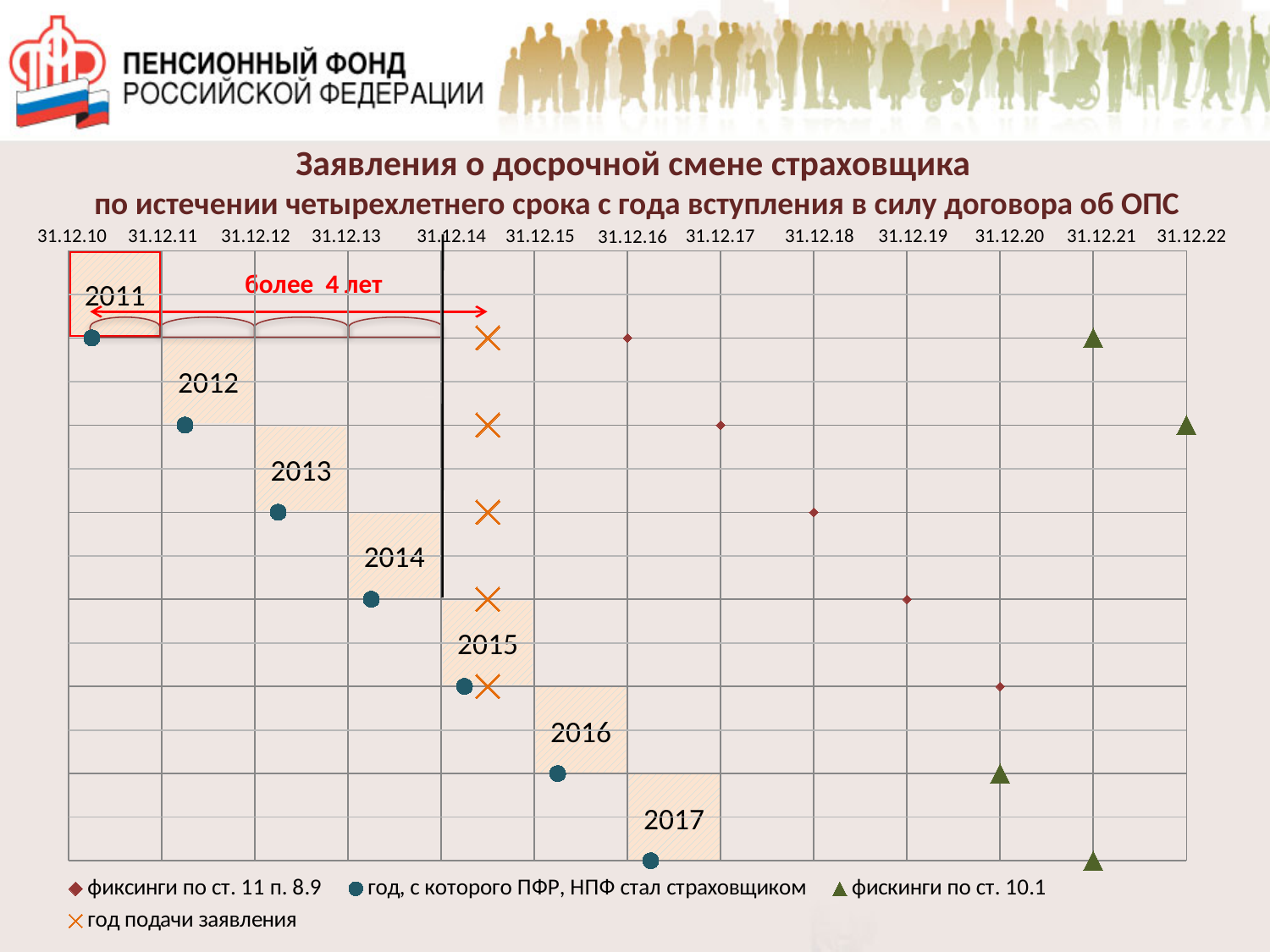
What kind of chart is shown on the slide? scatter chart How many X (cross) markers for 'год подачи заявления' are plotted? 5 How many year labels (2011, 2012, ...) are shown along the diagonal of the chart? 7 What is the first date label on the x axis? 31.12.10 Which year label is outlined with a red box? 2011 How many triangle markers for 'фиксинги по ст. 10.1' are plotted? 4 What text is written in red above the arrow at the top of the chart? более 4 лет What is the last date label on the x axis? 31.12.22 How many series does the legend list? 4